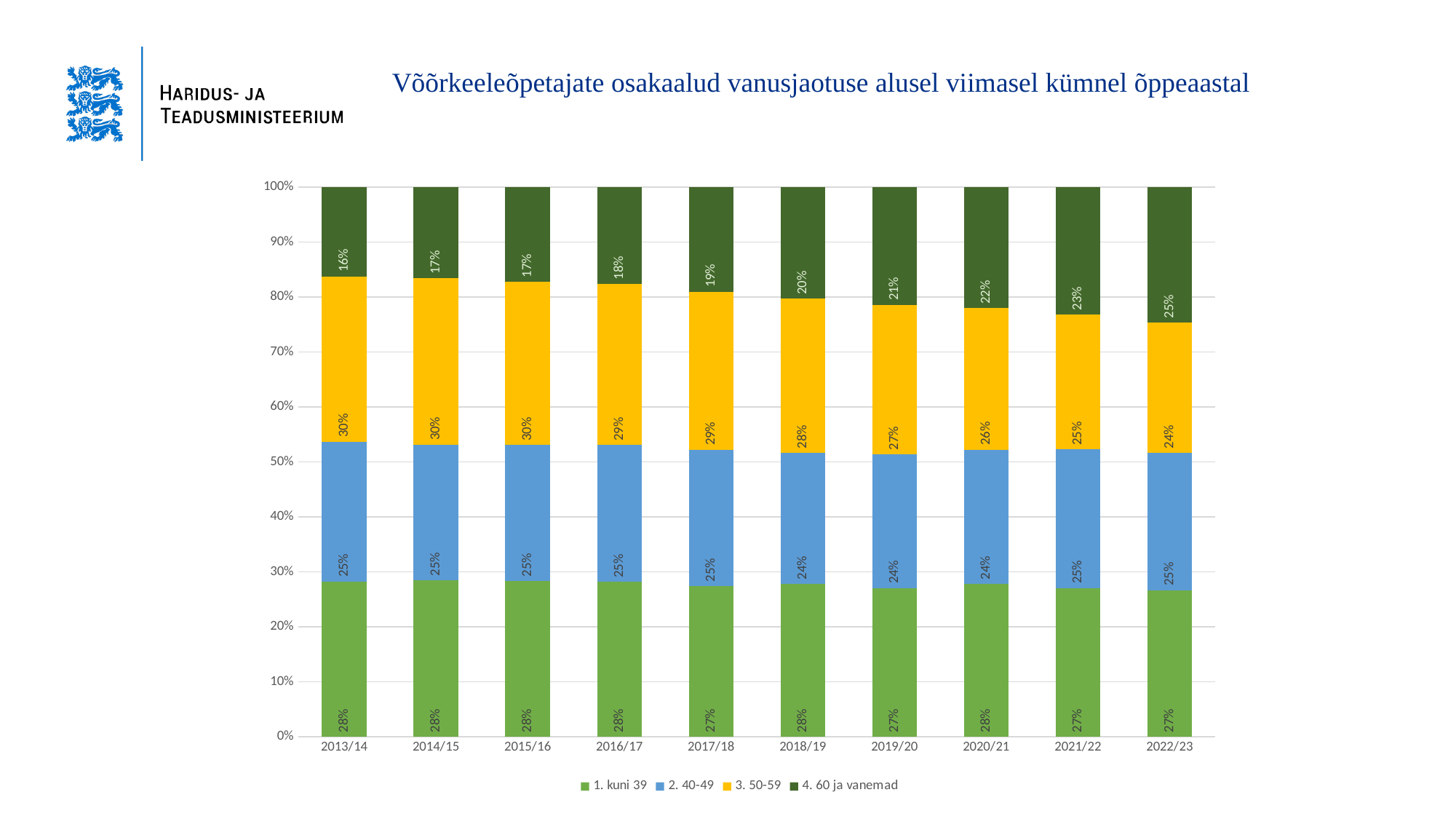
In which school year is the share of the '4. 60 ja vanemad' group highest? 2022/23 In which school year is the share of the '4. 60 ja vanemad' group lowest? 2013/14 What is the title of the chart? Võõrkeeleõpetajate osakaalud vanusjaotuse alusel viimasel kümnel õppeaastal What is the difference between the '3. 50-59' share in 2013/14 and in 2022/23? 6 percentage points What is the share of the '4. 60 ja vanemad' group in 2022/23? 25% How many school years are shown on the x axis? 10 What kind of chart is shown on the slide? stacked bar chart In 2020/21, which group has the larger share: '3. 50-59' or '4. 60 ja vanemad'? 3. 50-59 Does the share of the '4. 60 ja vanemad' group rise or fall from 2013/14 to 2022/23? rise What is the share of the '3. 50-59' group in 2013/14? 30% What is the share of the '1. kuni 39' group in 2017/18? 27% How many series does the legend list? 4